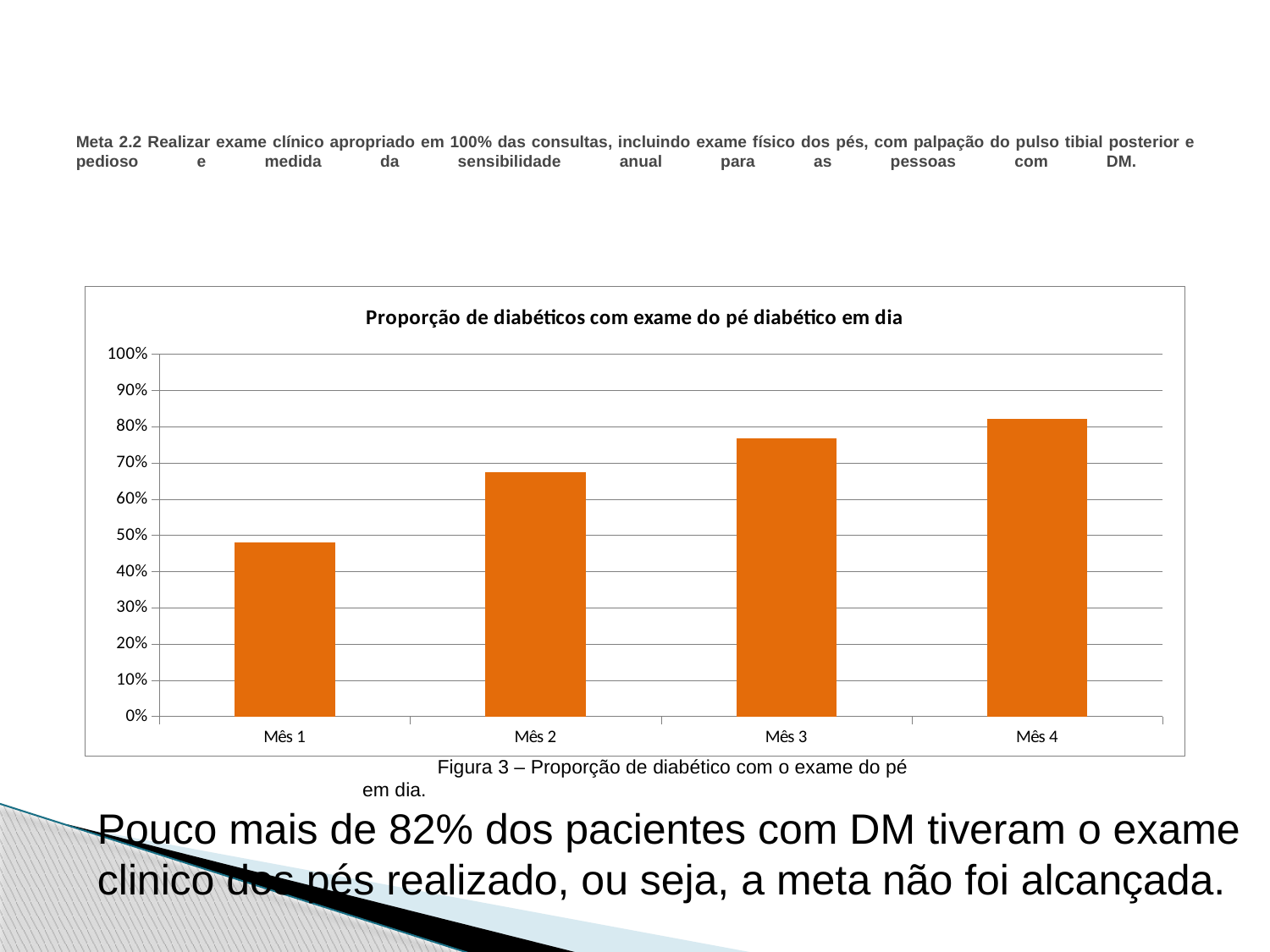
Do the values rise or fall from Mês 1 to Mês 4? rise Which is larger, the value for Mês 1 or the value for Mês 4? Mês 4 Which month has the highest proportion of diabetics with the foot exam up to date? Mês 4 What kind of chart is shown on the slide? bar chart Is the value for Mês 1 greater or less than 60%? less Is the value for Mês 3 greater or less than 70%? greater Which month has the lowest proportion of diabetics with the foot exam up to date? Mês 1 How many categories (months) are plotted on the chart? 4 What is the title of the chart? Proporção de diabéticos com exame do pé diabético em dia Is the value for Mês 4 greater or less than 90%? less Which is larger, the value for Mês 2 or the value for Mês 3? Mês 3